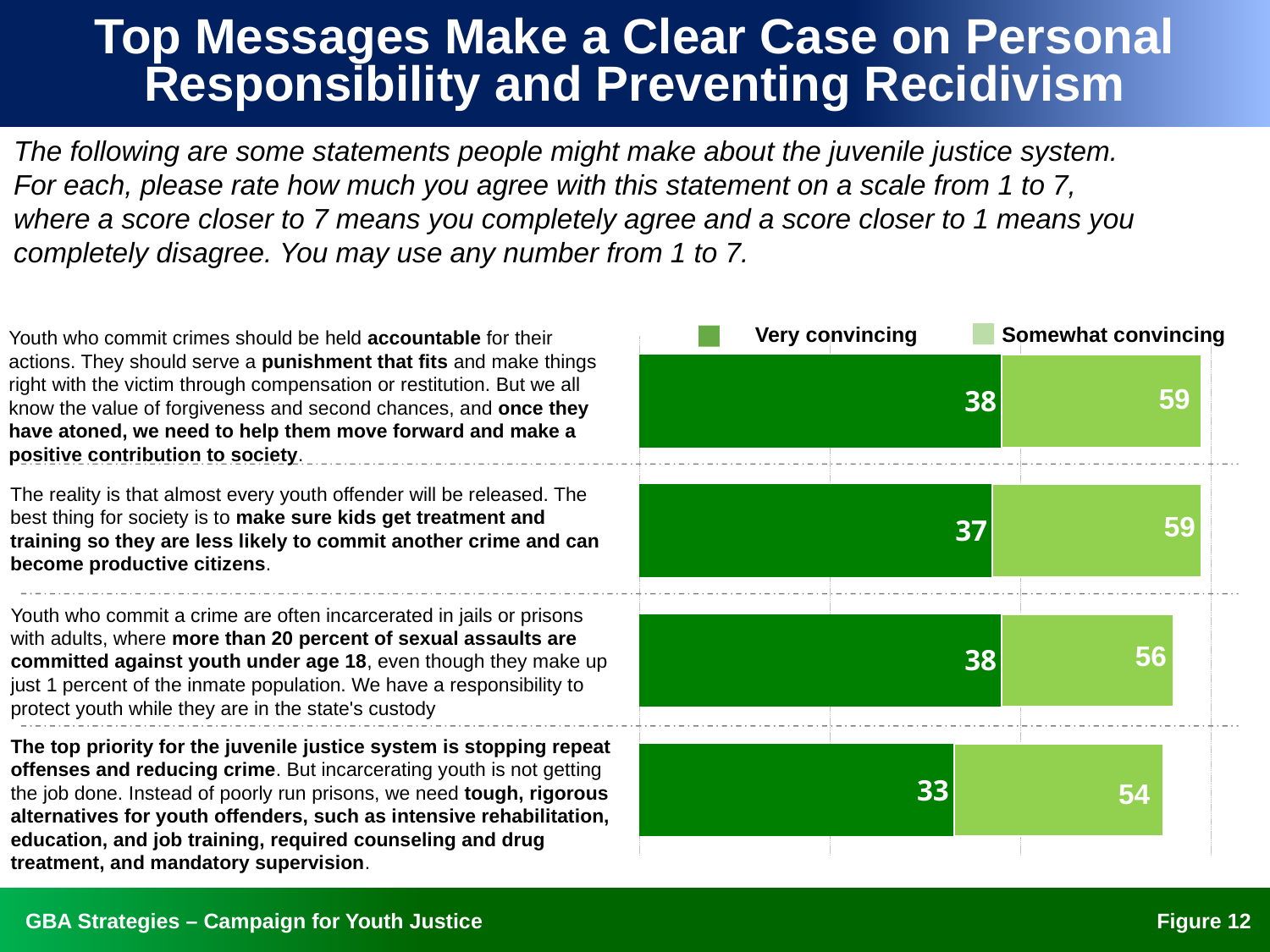
What is the 'Very convincing' value for the second statement (almost every youth offender will be released)? 37 How many statements are plotted in the chart? 4 What is the difference between the 'Very convincing' values of the top statement and the bottom statement? 5 How many series does the chart legend list? 2 What is the 'Somewhat convincing' value for the third statement (youth incarcerated with adults)? 56 What is the 'Somewhat convincing' value for the bottom statement (top priority is stopping repeat offenses)? 54 Which has the larger 'Very convincing' value: the top statement or the bottom statement? The top statement What is the 'Very convincing' value for the top statement (youth should be held accountable)? 38 What colour represents 'Very convincing' in the chart legend? Dark green What kind of chart is shown on the slide? Bar chart Which statement has the lowest 'Very convincing' value? The bottom statement (top priority is stopping repeat offenses), 33 What is the difference between the 'Somewhat convincing' values of the top statement and the bottom statement? 5